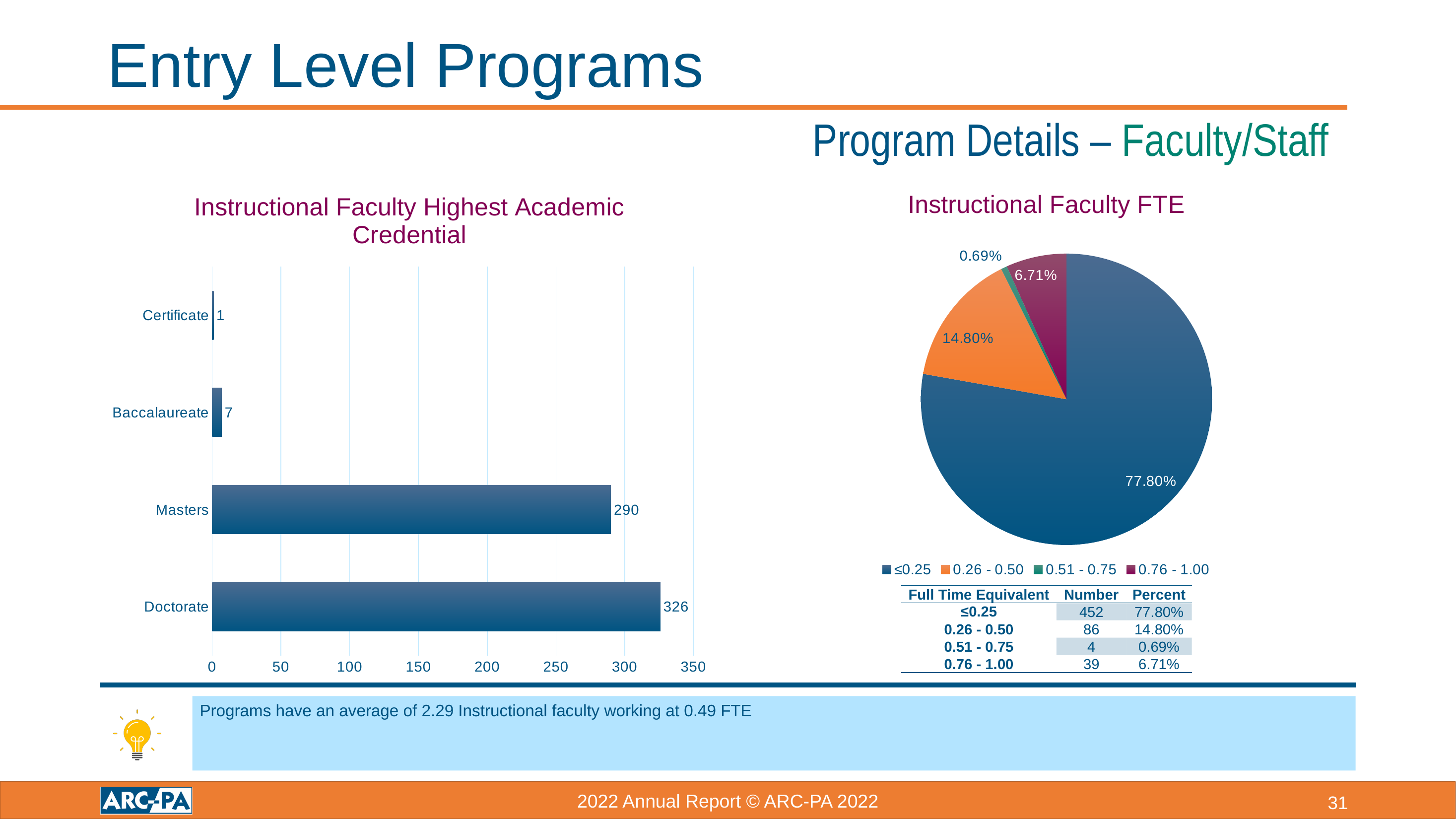
In the 'Instructional Faculty FTE' pie chart, what share does the 0.76 - 1.00 slice have? 6.71% In the 'Instructional Faculty Highest Academic Credential' chart, which category has the highest value? Doctorate In the 'Instructional Faculty Highest Academic Credential' chart, which category has the lowest value? Certificate What kind of chart is the 'Instructional Faculty FTE' chart? Pie chart In the 'Instructional Faculty Highest Academic Credential' chart, what is the value for Masters? 290 In the 'Instructional Faculty FTE' pie chart, which slice is the largest? ≤0.25 What kind of chart is the 'Instructional Faculty Highest Academic Credential' chart? Bar chart In the 'Instructional Faculty FTE' pie chart, what share does the 0.26 - 0.50 slice have? 14.80% In the 'Instructional Faculty Highest Academic Credential' chart, what is the value for Baccalaureate? 7 In the 'Instructional Faculty FTE' pie chart, how many entries does the legend list? 4 In the 'Instructional Faculty Highest Academic Credential' chart, how many categories are shown? 4 In the 'Instructional Faculty Highest Academic Credential' chart, what is the difference between the Doctorate and Masters values? 36